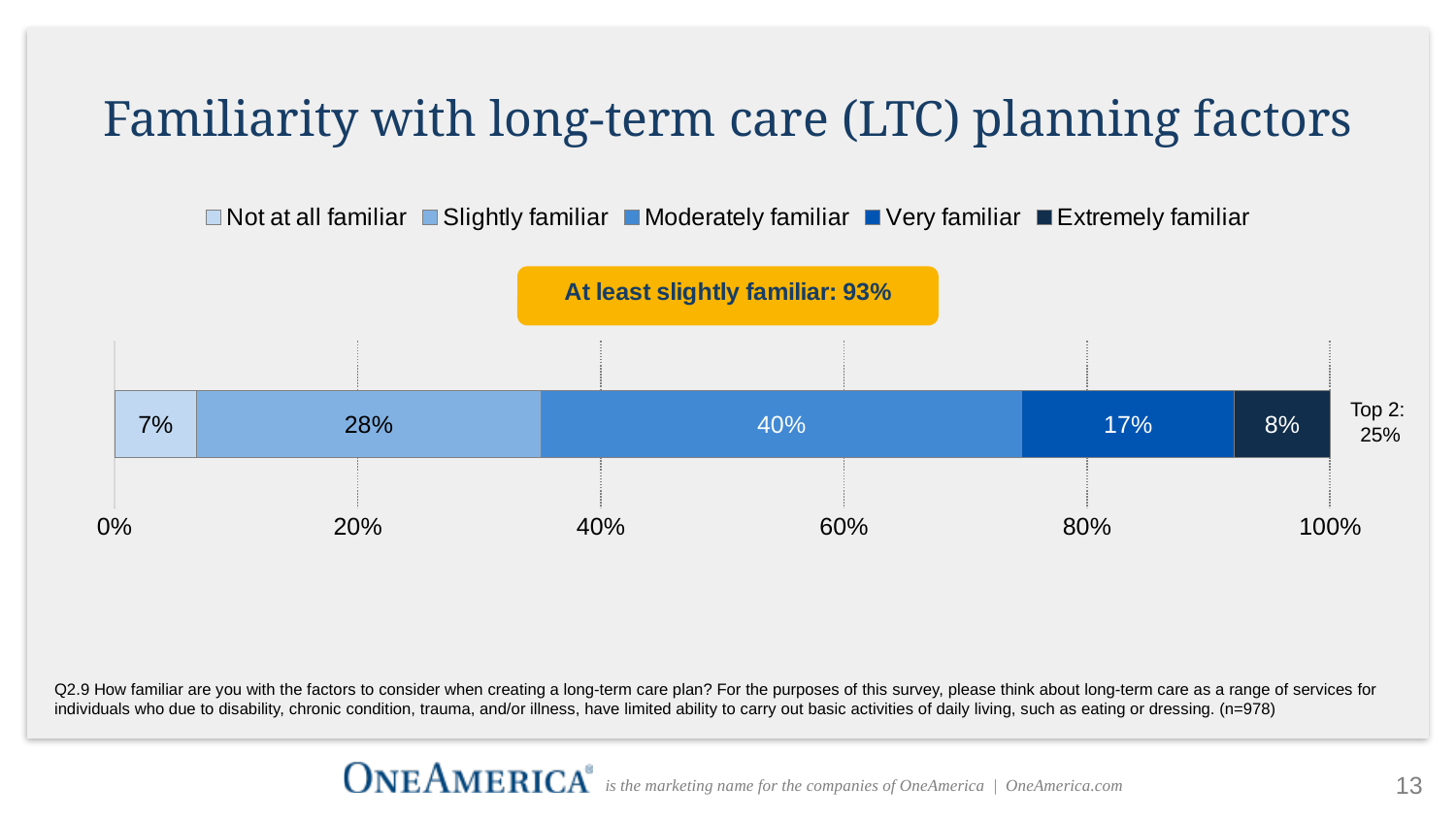
What percentage of respondents are 'Very familiar' with LTC planning factors? 17% What percentage of respondents are 'Moderately familiar' with LTC planning factors? 40% What is the difference between the 'Slightly familiar' and 'Very familiar' percentages? 11% Which familiarity level has the smallest share of respondents? Not at all familiar What kind of chart is shown on the slide? Stacked bar chart What is the 'Top 2' percentage shown to the right of the bar? 25% Which familiarity level has the largest share of respondents? Moderately familiar What percentage of respondents are at least slightly familiar with LTC planning factors, according to the callout? 93% What percentage of respondents are 'Extremely familiar' with LTC planning factors? 8% Which is larger, the 'Slightly familiar' share or the 'Extremely familiar' share? Slightly familiar How many series does the legend list? 5 What percentage of respondents are 'Not at all familiar' with LTC planning factors? 7%